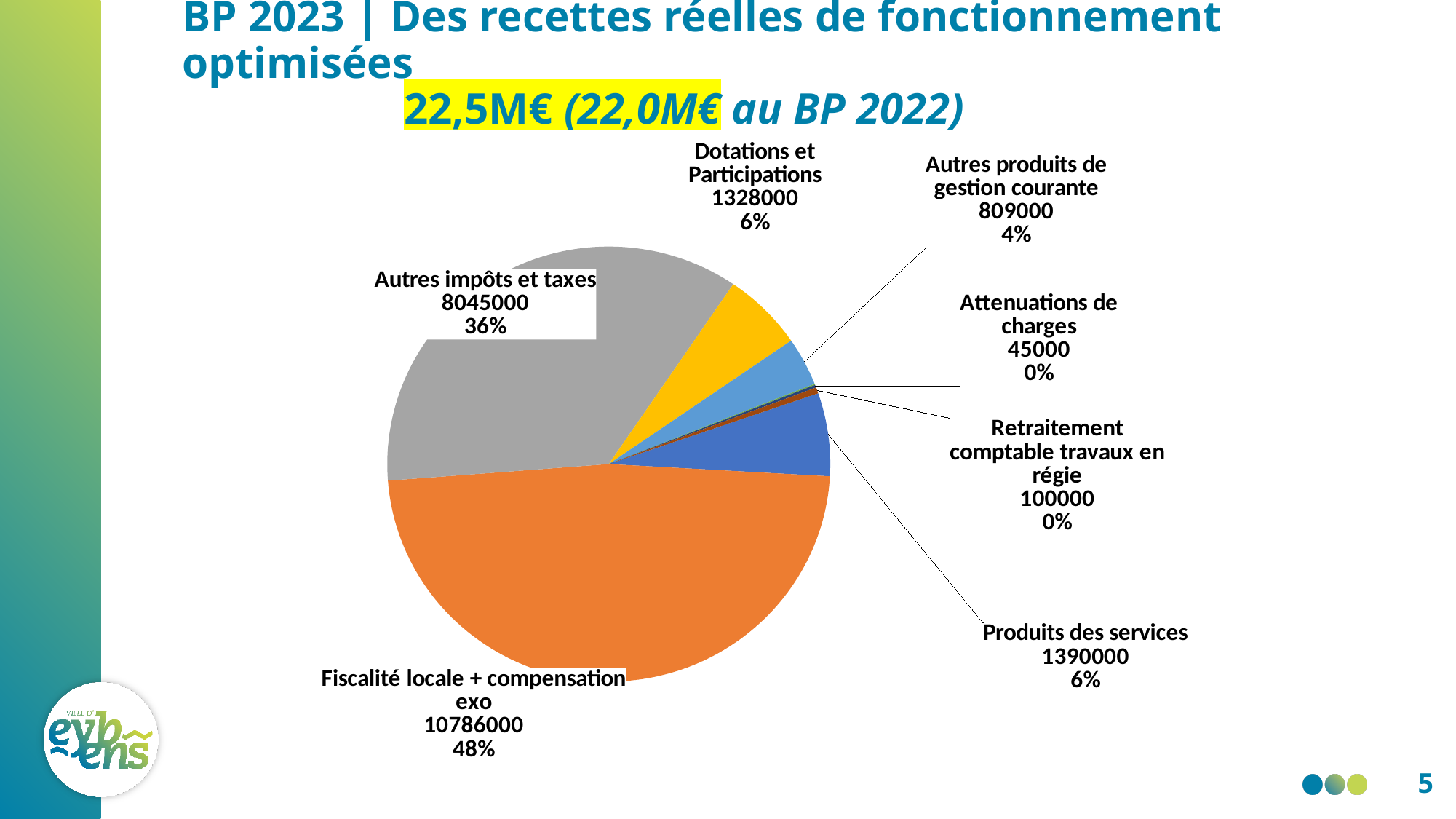
What share of the pie does Autres produits de gestion courante represent? 4% What share of the pie does Autres impôts et taxes represent? 36% Which is larger, the value for Autres produits de gestion courante or the value for Retraitement comptable travaux en régie? Autres produits de gestion courante What is the value for Fiscalité locale + compensation exo? 10786000 What is the value for Dotations et Participations? 1328000 What is the difference between the values for Produits des services and Dotations et Participations? 62000 What type of chart is shown on the slide? pie chart What total amount is stated in the subtitle above the pie chart for BP 2023? 22,5M€ What is the value for Produits des services? 1390000 Which category has the largest slice of the pie? Fiscalité locale + compensation exo